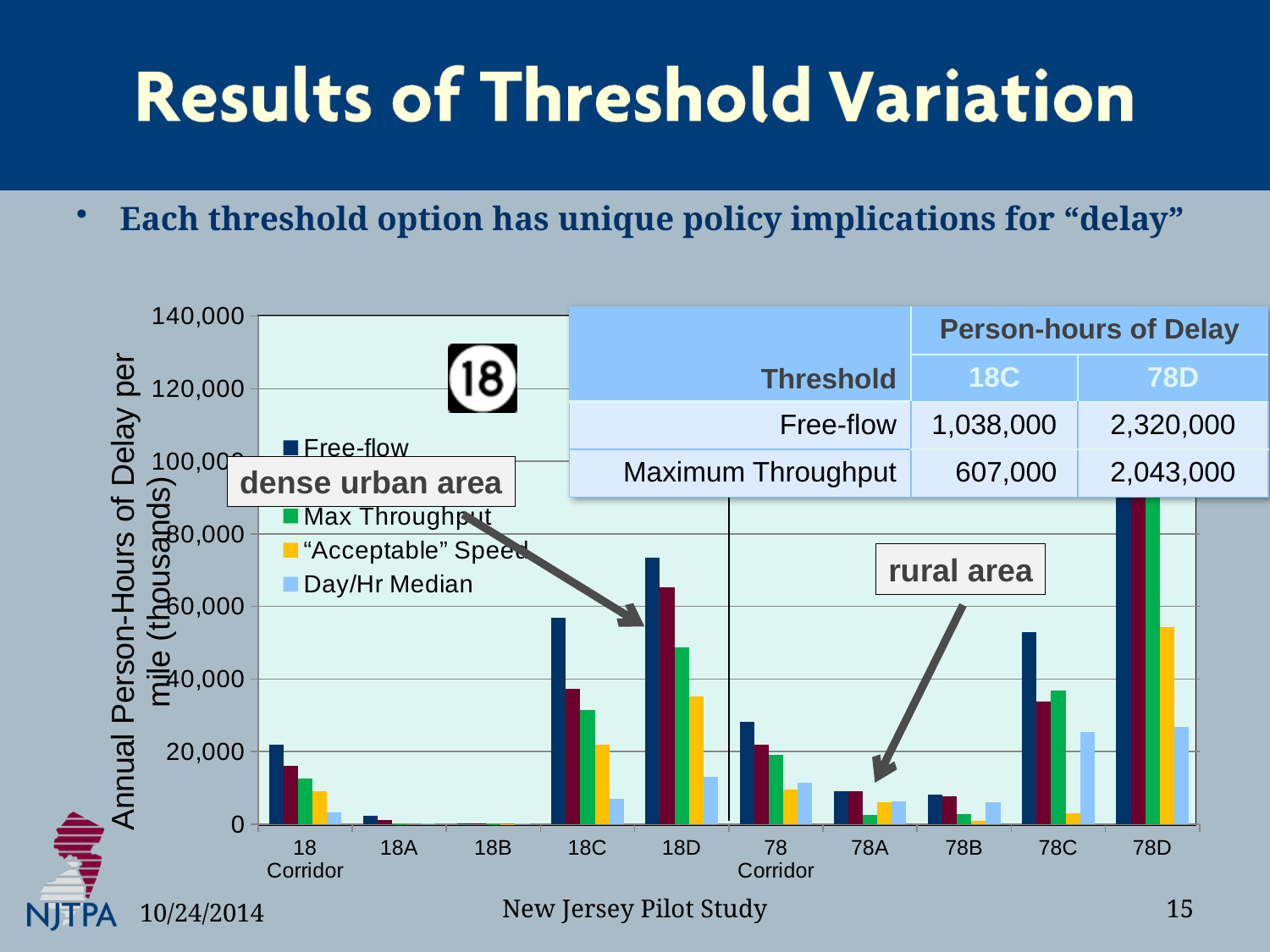
Is the "Acceptable" Speed value for 78D greater or less than 40,000? greater What kind of chart is shown on the slide? bar chart Is the Free-flow value for 18D greater or less than 60,000? greater Which category has the lowest Free-flow value? 18B Which has the larger Max Throughput value, 78C or 78D? 78D Is the Free-flow value for the 78 Corridor greater or less than 40,000? less Which category has the highest Free-flow value? 78D How many categories are shown along the x axis of the chart? 10 What is the title of the chart's vertical axis? Annual Person-Hours of Delay per mile (thousands) Which has the larger Free-flow value, 18C or 18D? 18D